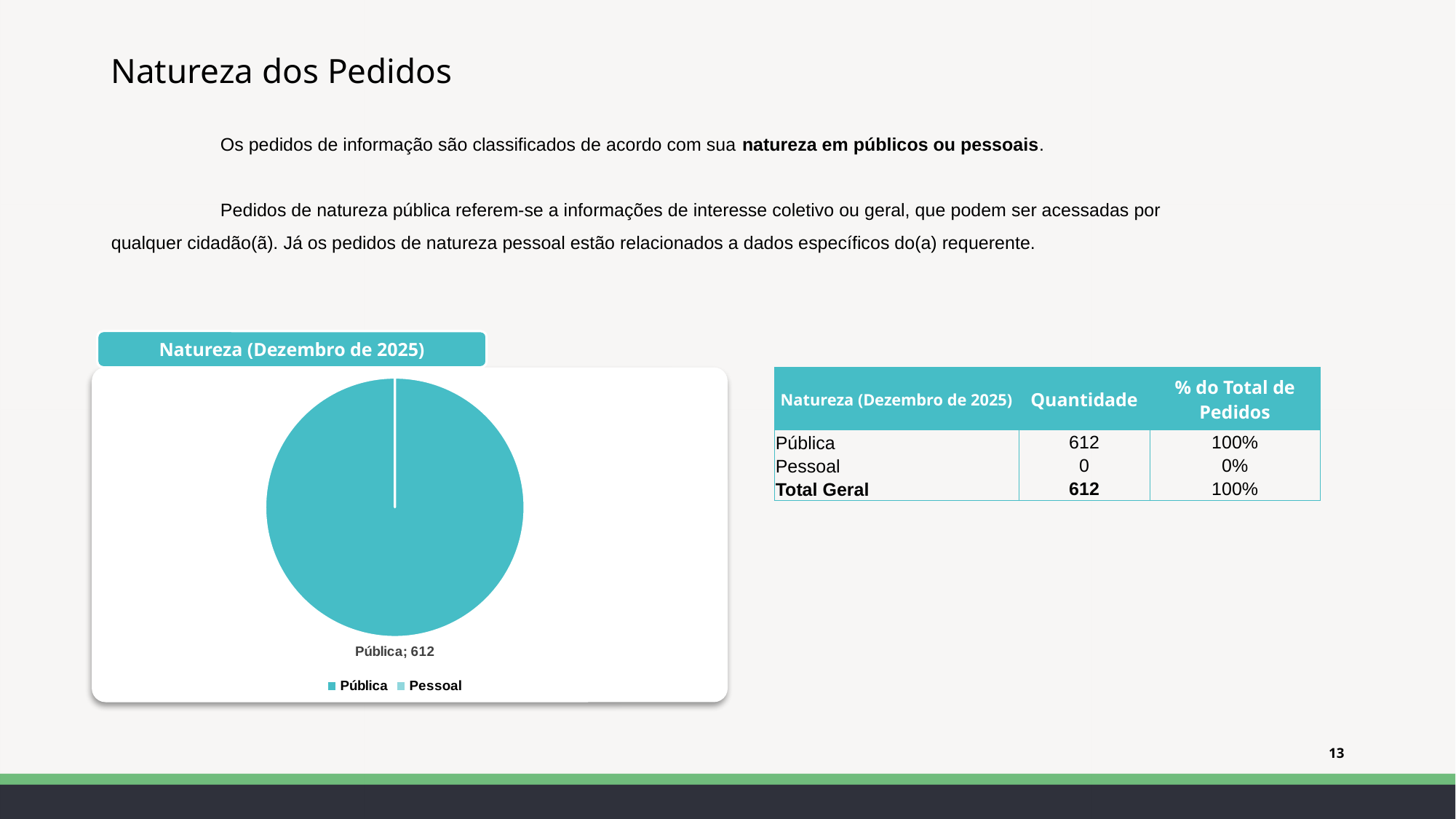
What is the title of the pie chart? Natureza (Dezembro de 2025) Which category has the largest slice in the pie chart? Pública What is the total of all categories in the pie chart? 612 What are the two legend entries of the pie chart? Pública and Pessoal What kind of chart is shown on the slide? pie chart How many entries does the legend of the pie chart list? 2 Which is larger in the pie chart, Pública or Pessoal? Pública What share of the pie does Pública represent? 100% What is the value for Pessoal according to the table next to the pie chart? 0 What is the value shown for Pública in the pie chart? 612